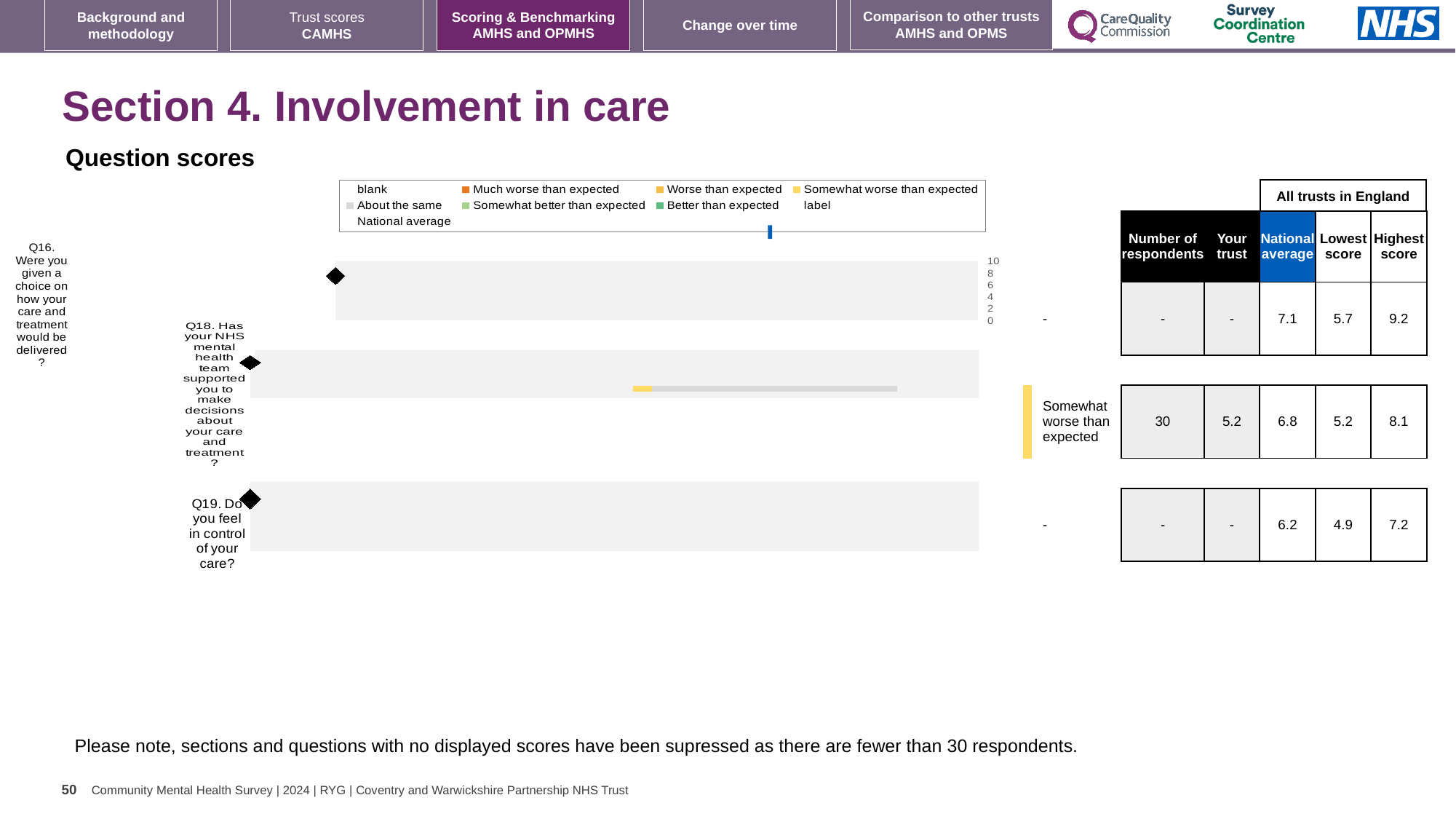
Which question has the lowest national average? Q19 What is the 'Your trust' score for Q18? 5.2 What kind of chart is shown under 'Question scores'? bar chart Which question has the highest national average? Q16 What is the difference between the national average and the 'Your trust' score for Q18? 1.6 What rating category is shown for Q18? Somewhat worse than expected What is the highest score across all trusts in England for Q19? 7.2 What is the national average for Q16? 7.1 How many entries does the chart legend list? 9 How many respondents are recorded for Q18? 30 How many questions are plotted on the chart? 3 What is the maximum value shown on the chart's axis? 10